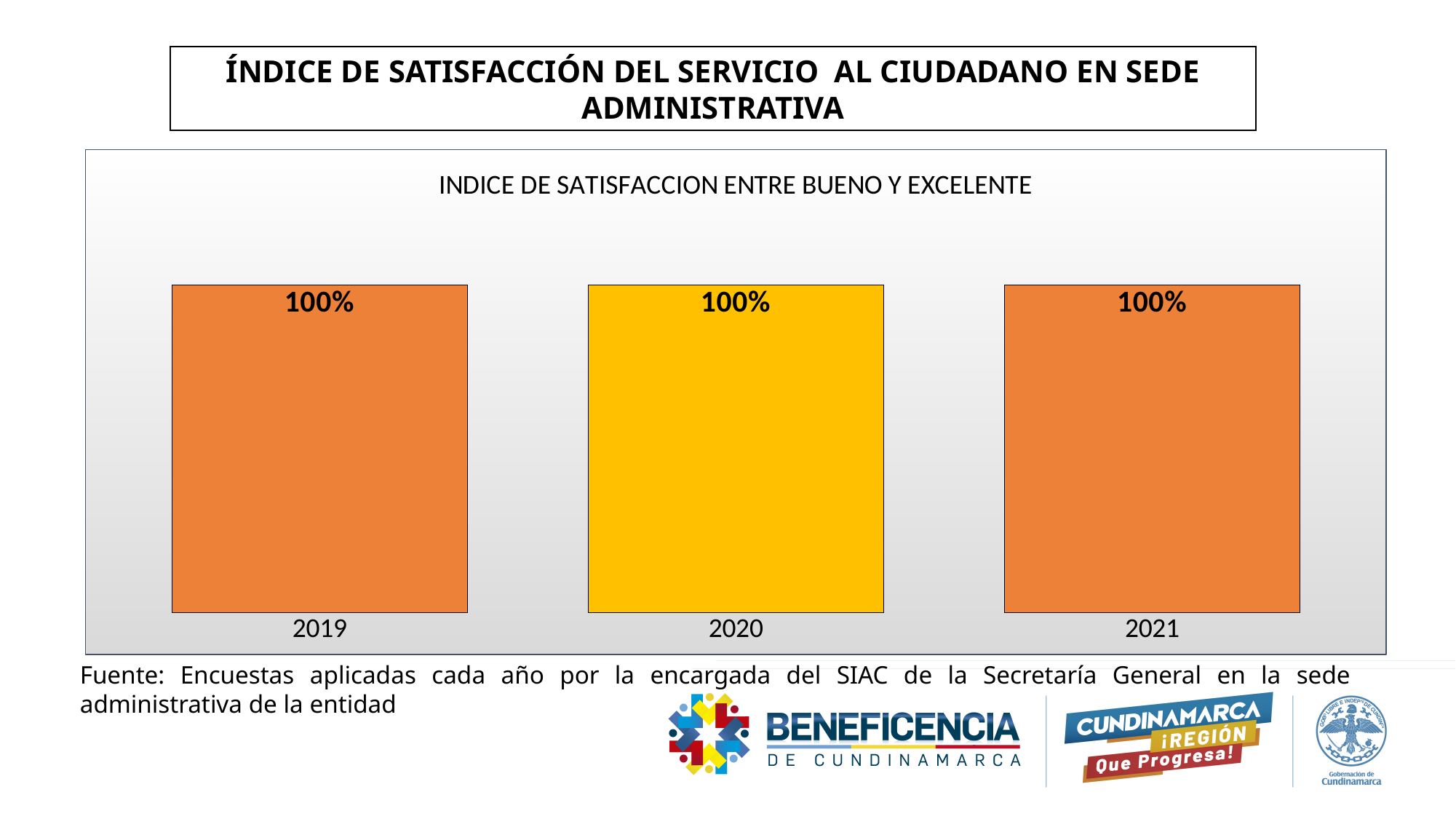
Which year is the first category on the x axis? 2019 What is the title of the chart? INDICE DE SATISFACCION ENTRE BUENO Y EXCELENTE What kind of chart is shown on the slide? Bar chart What is the value for 2020? 100% How many categories are shown on the x axis? 3 Do the values rise, fall or stay the same from 2019 to 2021? Stay the same Which bar is coloured yellow rather than orange? 2020 What is the difference between the values for 2019 and 2021? 0% What is the value for 2019? 100% What is the value for 2021? 100%